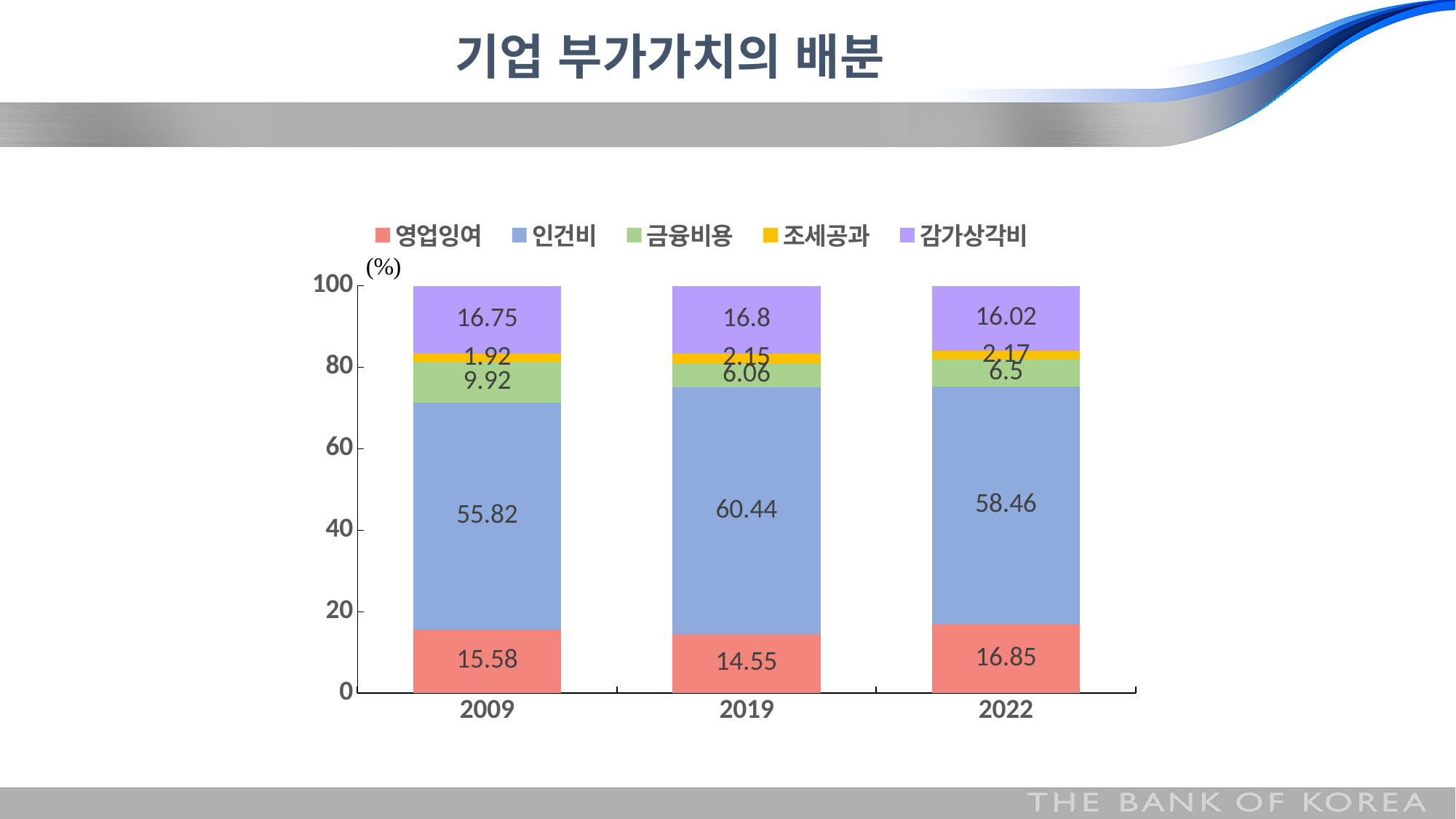
How many years are shown on the x axis? 3 What kind of chart is shown on the slide? Stacked bar chart What is the total of the stacked bar for 2022? 100 What is the value of 영업잉여 in 2022? 16.85 Does 조세공과 rise or fall from 2009 to 2022? Rise What is the value of 금융비용 in 2009? 9.92 How many series does the legend list? 5 In which year is 조세공과 the lowest? 2009 Which is larger, 감가상각비 in 2019 or in 2022? 2019 In which year is 인건비 the highest? 2019 What is the value of 인건비 in 2019? 60.44 What is the difference between 인건비 in 2019 and in 2009? 4.62